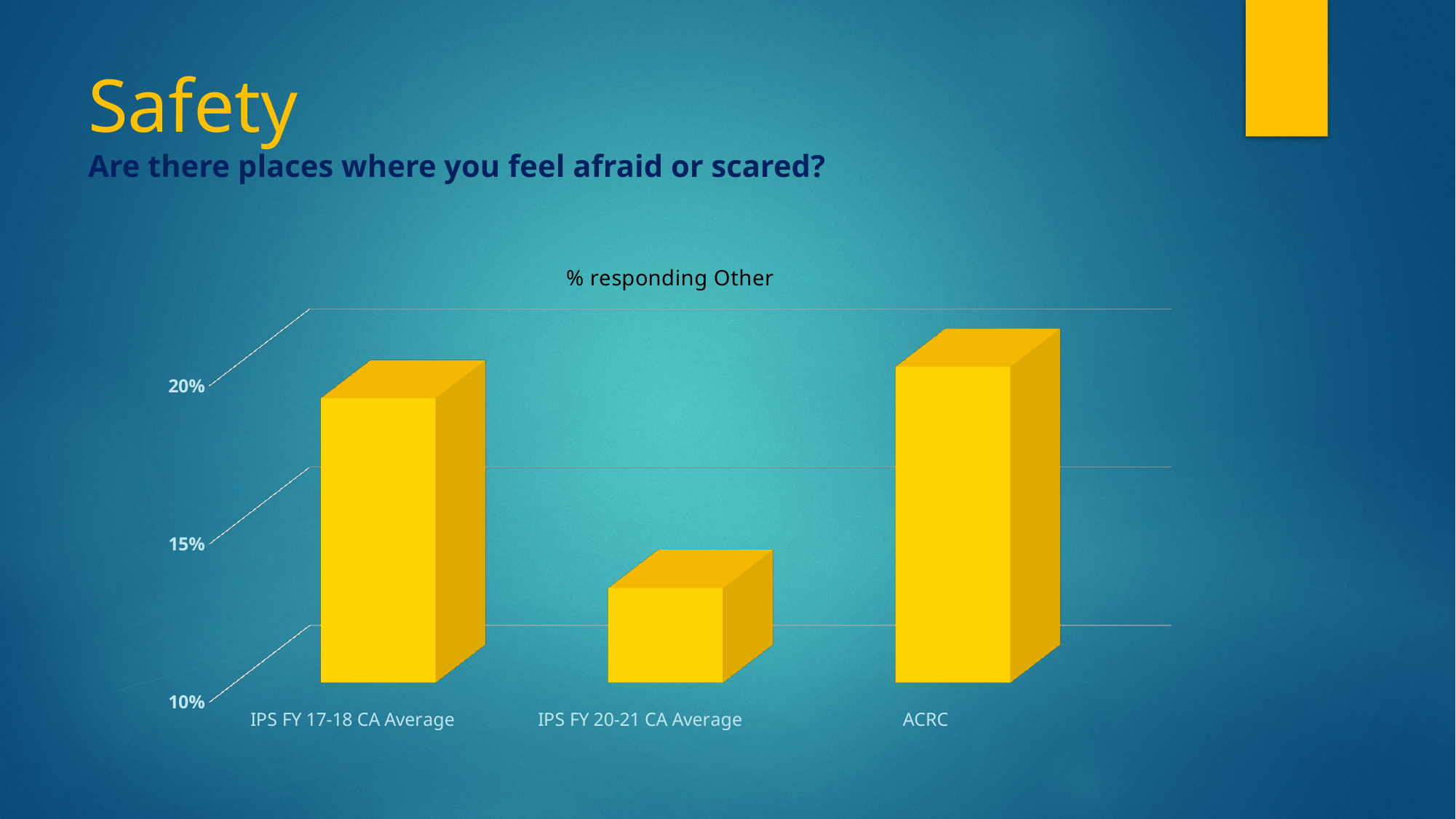
Is the value for IPS FY 20-21 CA Average greater or less than 10%? greater What type of chart is shown on the slide? Bar chart How many categories are plotted in the chart? 3 Which category has the lowest value in the chart? IPS FY 20-21 CA Average Which is larger, the value for ACRC or the value for IPS FY 20-21 CA Average? ACRC Is the value for ACRC greater or less than 15%? greater Is the value for IPS FY 20-21 CA Average greater or less than 15%? less What colour are the bars in the chart? Yellow Which category has the highest value in the chart? ACRC What is the title of the chart? % responding Other Which is larger, the value for IPS FY 17-18 CA Average or the value for IPS FY 20-21 CA Average? IPS FY 17-18 CA Average